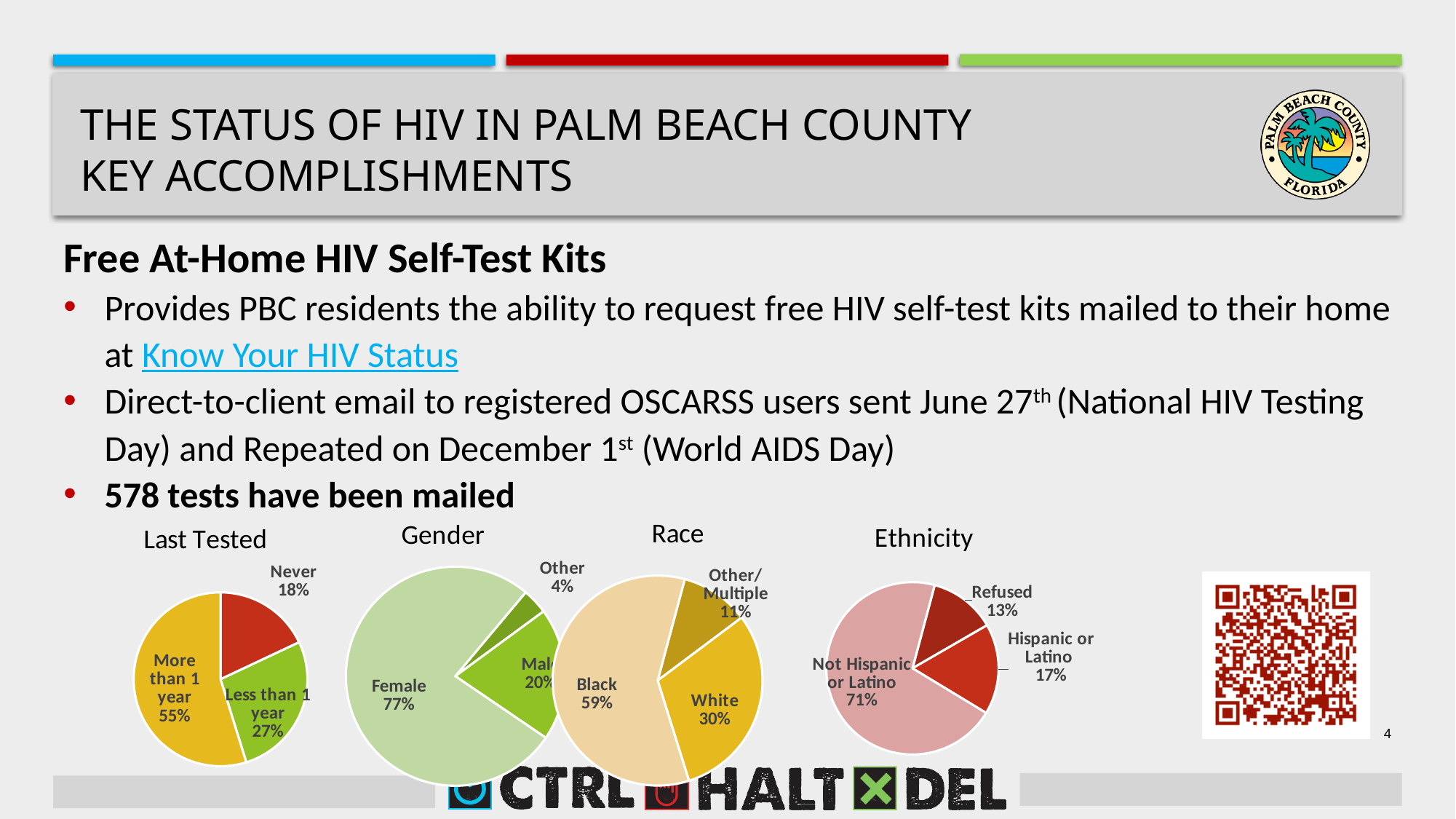
In the Ethnicity chart, which is larger, Refused or Hispanic or Latino? Hispanic or Latino In the Race chart, what percentage is White? 30% In the Ethnicity chart, what percentage is Hispanic or Latino? 17% In the Last Tested chart, what share of respondents were last tested more than 1 year ago? 55% How many pie charts are shown on the slide? 4 In the Gender chart, how many slices are there? 3 In the Last Tested chart, what percentage of respondents have never been tested? 18% In the Last Tested chart, which category has the smallest share? Never In the Gender chart, what percentage is Female? 77% In the Race chart, which category has the largest share? Black In the Gender chart, what is the difference between the Female and Male shares? 57% What kind of chart is the Race chart? Pie chart